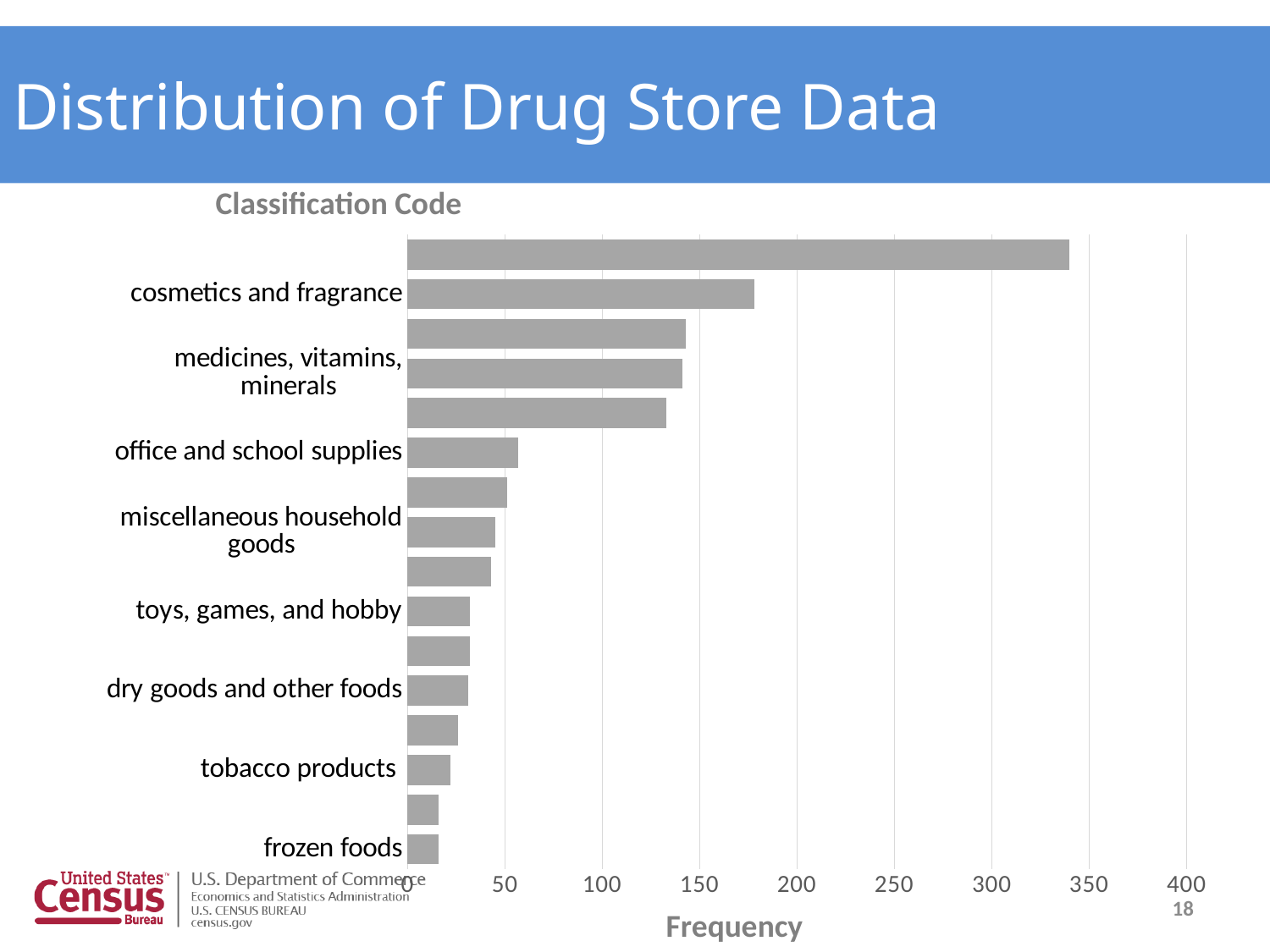
Is the value for medicines, vitamins, minerals greater or less than 100? greater Is the value for medicines, vitamins, minerals greater or less than 150? less Is the value for cosmetics and fragrance greater or less than 150? greater What is the label on the horizontal axis of the chart? Frequency Which has the larger value, miscellaneous household goods or toys, games, and hobby? miscellaneous household goods How many bars are plotted in the chart? 16 What kind of chart is shown on the slide? bar chart Do the bars get longer or shorter going from the top of the chart to the bottom? shorter Which has the larger value, cosmetics and fragrance or medicines, vitamins, minerals? cosmetics and fragrance